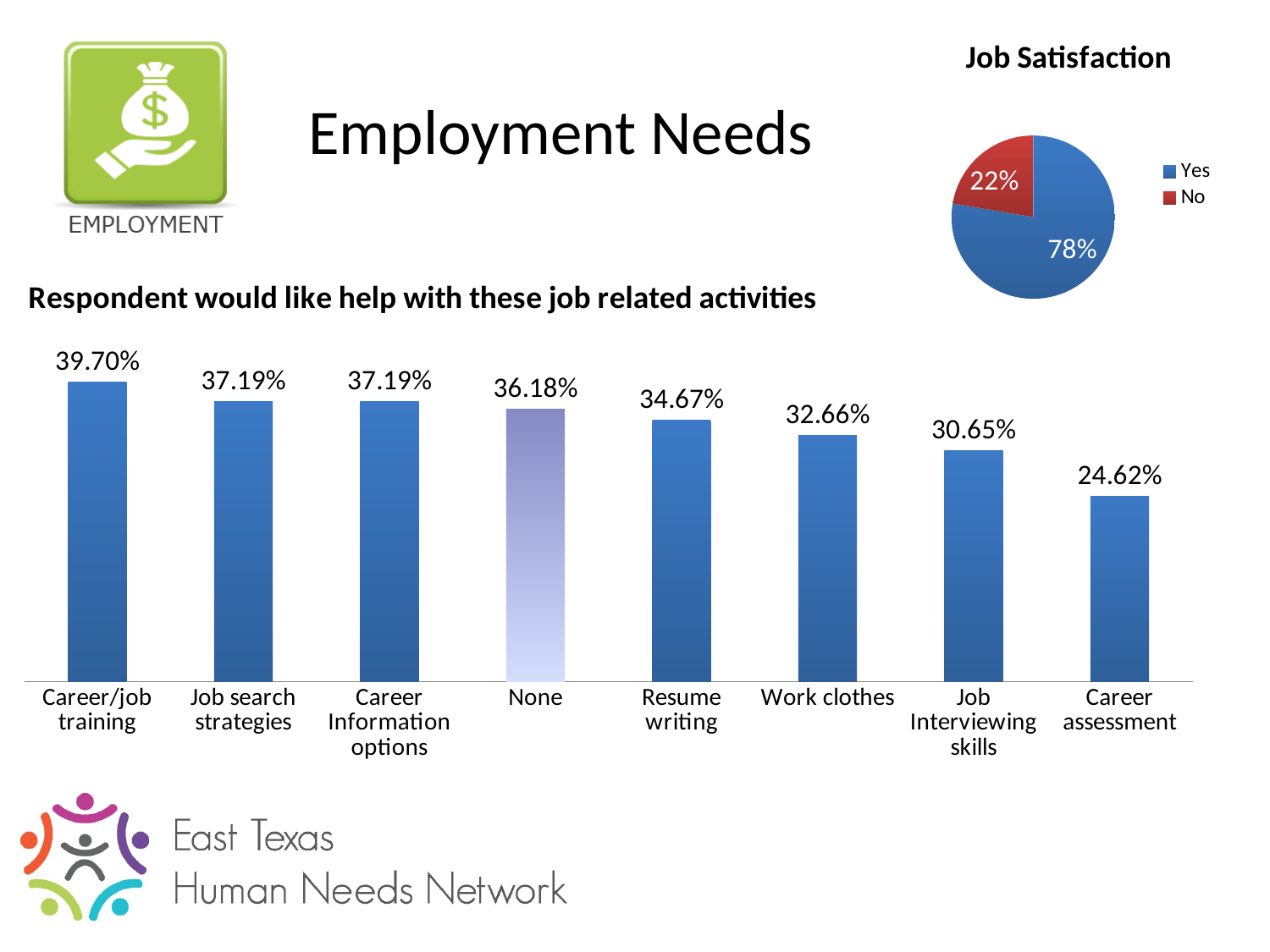
In the bar chart 'Respondent would like help with these job related activities', which category has the highest value? Career/job training In the 'Job Satisfaction' pie chart, what share of respondents answered Yes? 78% In the bar chart 'Respondent would like help with these job related activities', which is larger: Resume writing or Job Interviewing skills? Resume writing In the 'Job Satisfaction' pie chart, what share of respondents answered No? 22% In the bar chart 'Respondent would like help with these job related activities', what is the value for Work clothes? 32.66% What kind of chart is 'Respondent would like help with these job related activities'? Bar chart How many categories are shown in the bar chart 'Respondent would like help with these job related activities'? 8 In the bar chart 'Respondent would like help with these job related activities', what is the difference between Career/job training and Career assessment? 15.08% What kind of chart is 'Job Satisfaction'? Pie chart In the bar chart 'Respondent would like help with these job related activities', which category has the lowest value? Career assessment In the bar chart 'Respondent would like help with these job related activities', what is the value for None? 36.18% In the bar chart 'Respondent would like help with these job related activities', what is the value for Career/job training? 39.70%